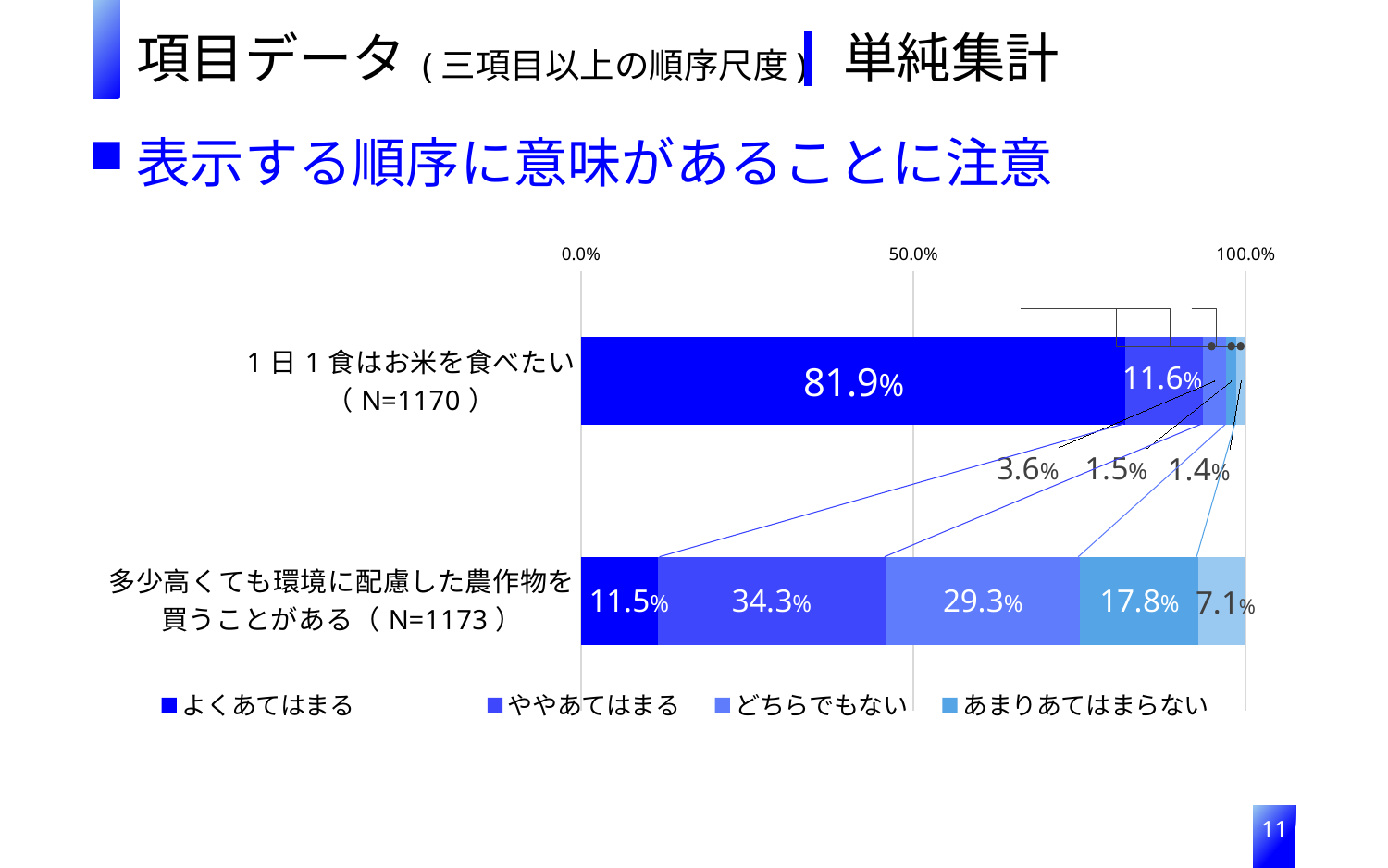
What is the difference between the よくあてはまる values of the two bars (81.9% and 11.5%)? 70.4 percentage points What is the value of ややあてはまる for 1日1食はお米を食べたい（N=1170）? 11.6% What is the value of よくあてはまる for 多少高くても環境に配慮した農作物を買うことがある（N=1173）? 11.5% What is the value of よくあてはまる for 1日1食はお米を食べたい（N=1170）? 81.9% Is the よくあてはまる value for 1日1食はお米を食べたい greater or less than 50.0%? greater What kind of chart is shown on the slide? Stacked bar chart Which is larger: ややあてはまる for 1日1食はお米を食べたい or ややあてはまる for 多少高くても環境に配慮した農作物を買うことがある? 多少高くても環境に配慮した農作物を買うことがある (34.3%) What is the N (sample size) shown for 多少高くても環境に配慮した農作物を買うことがある? N=1173 How many categories (bars) are plotted in the chart? 2 What is the value of あまりあてはまらない for 多少高くても環境に配慮した農作物を買うことがある（N=1173）? 17.8% Which segment is the largest in the bar for 多少高くても環境に配慮した農作物を買うことがある（N=1173）? ややあてはまる (34.3%) What is the value of どちらでもない for 多少高くても環境に配慮した農作物を買うことがある（N=1173）? 29.3%